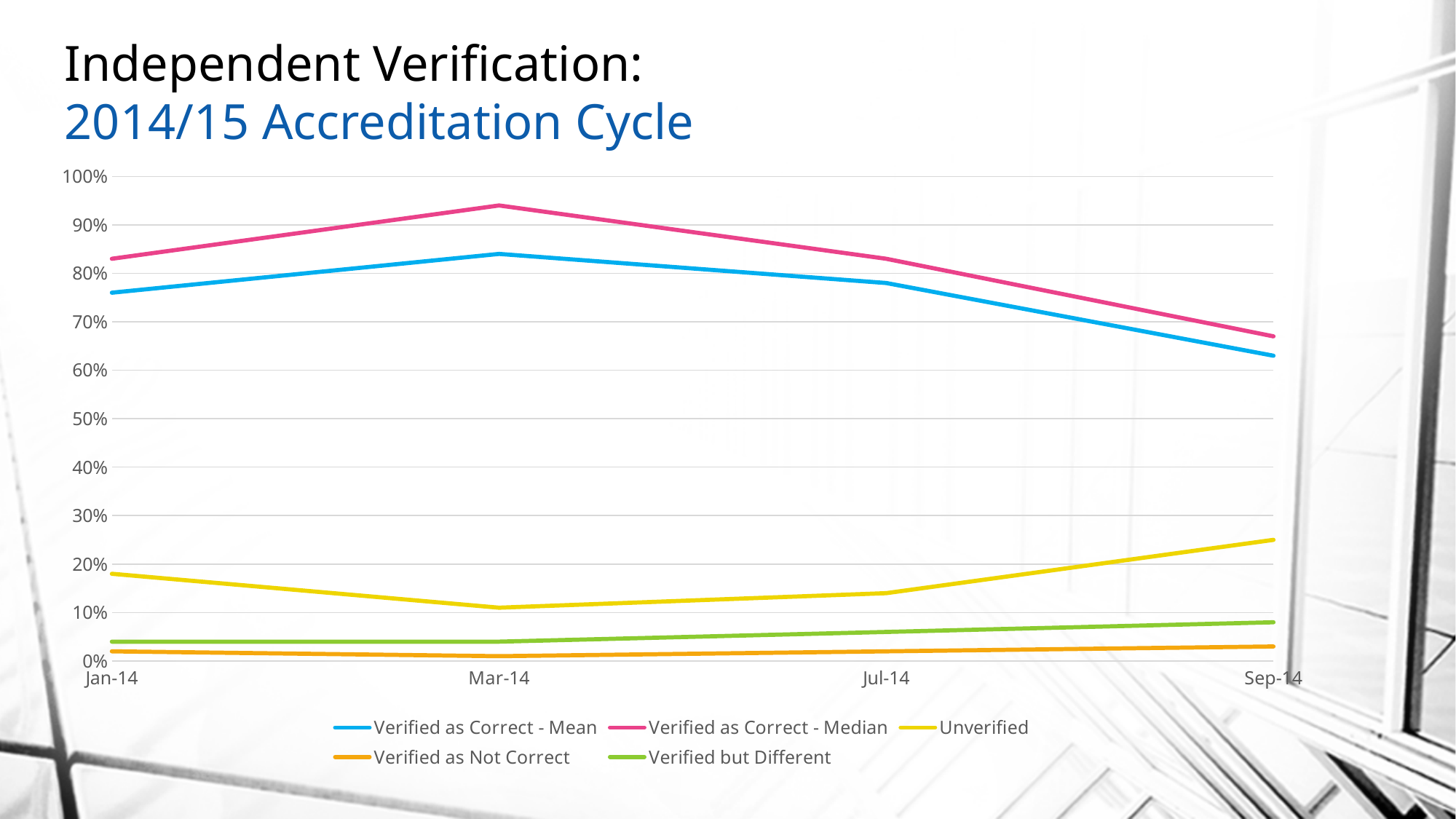
Is the value for Verified as Correct - Mean at Sep-14 greater or less than 70%? less At which x-axis point is the Unverified line at its lowest value? Mar-14 What kind of chart is shown on the slide? line chart At Jan-14, which is higher: Verified as Correct - Mean or Verified as Correct - Median? Verified as Correct - Median Does the Verified as Correct - Mean line rise or fall from Mar-14 to Sep-14? fall Does the Unverified line rise or fall from Mar-14 to Sep-14? rise How many series does the legend list? 5 Is the value for Verified as Correct - Median at Mar-14 greater or less than 90%? greater What colour is the Unverified line in the chart? yellow At which x-axis point does the Verified as Correct - Median line reach its highest value? Mar-14 How many points are labelled along the x axis? 4 Is the value for Unverified at Sep-14 greater or less than 20%? greater